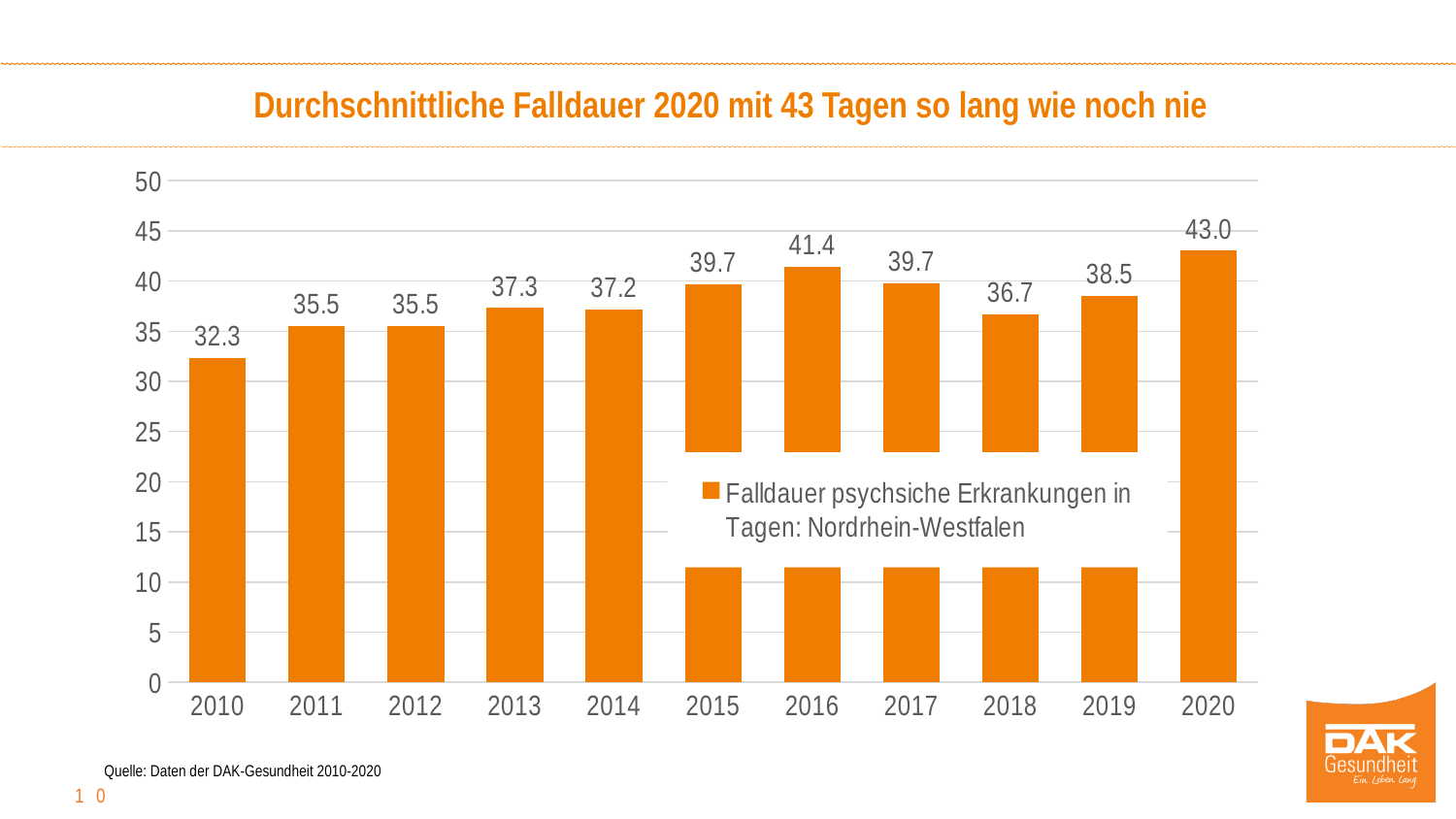
What is the value for 2016? 41.4 Is the value for 2013 greater or less than 35? greater What is the value for 2010? 32.3 What kind of chart is shown? bar chart How many years are shown on the x axis? 11 What is the difference between the values for 2020 and 2010? 10.7 Which year has the highest value? 2020 Which is larger, the value for 2016 or the value for 2019? 2016 What is the value for 2018? 36.7 Which year has the lowest value? 2010 What is the legend entry of the series? Falldauer psychsiche Erkrankungen in Tagen: Nordrhein-Westfalen What is the value for 2020? 43.0